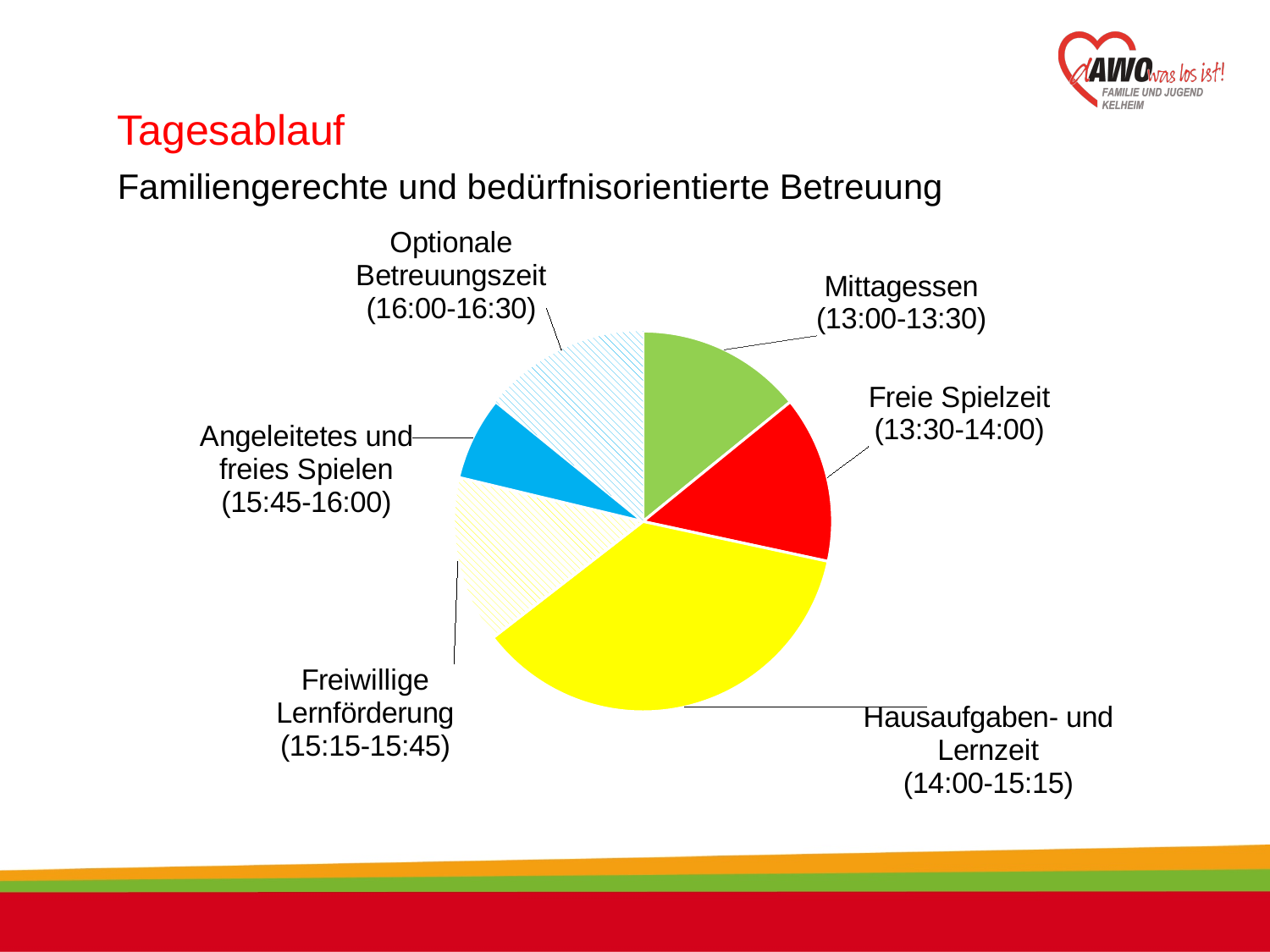
What time range is shown for Mittagessen? 13:00-13:30 What colour is the Freie Spielzeit slice? red What time range is shown for Hausaufgaben- und Lernzeit? 14:00-15:15 What time range is shown for Freiwillige Lernförderung? 15:15-15:45 How many slices does the pie chart have? 6 Which slice is larger: Hausaufgaben- und Lernzeit or Mittagessen? Hausaufgaben- und Lernzeit Which slice of the pie chart is the smallest? Angeleitetes und freies Spielen What is the title of the slide containing the pie chart? Tagesablauf Which slice of the pie chart is the largest? Hausaufgaben- und Lernzeit What time range is shown for Optionale Betreuungszeit? 16:00-16:30 Which slice is larger: Freie Spielzeit or Angeleitetes und freies Spielen? Freie Spielzeit What kind of chart is shown on the slide? pie chart